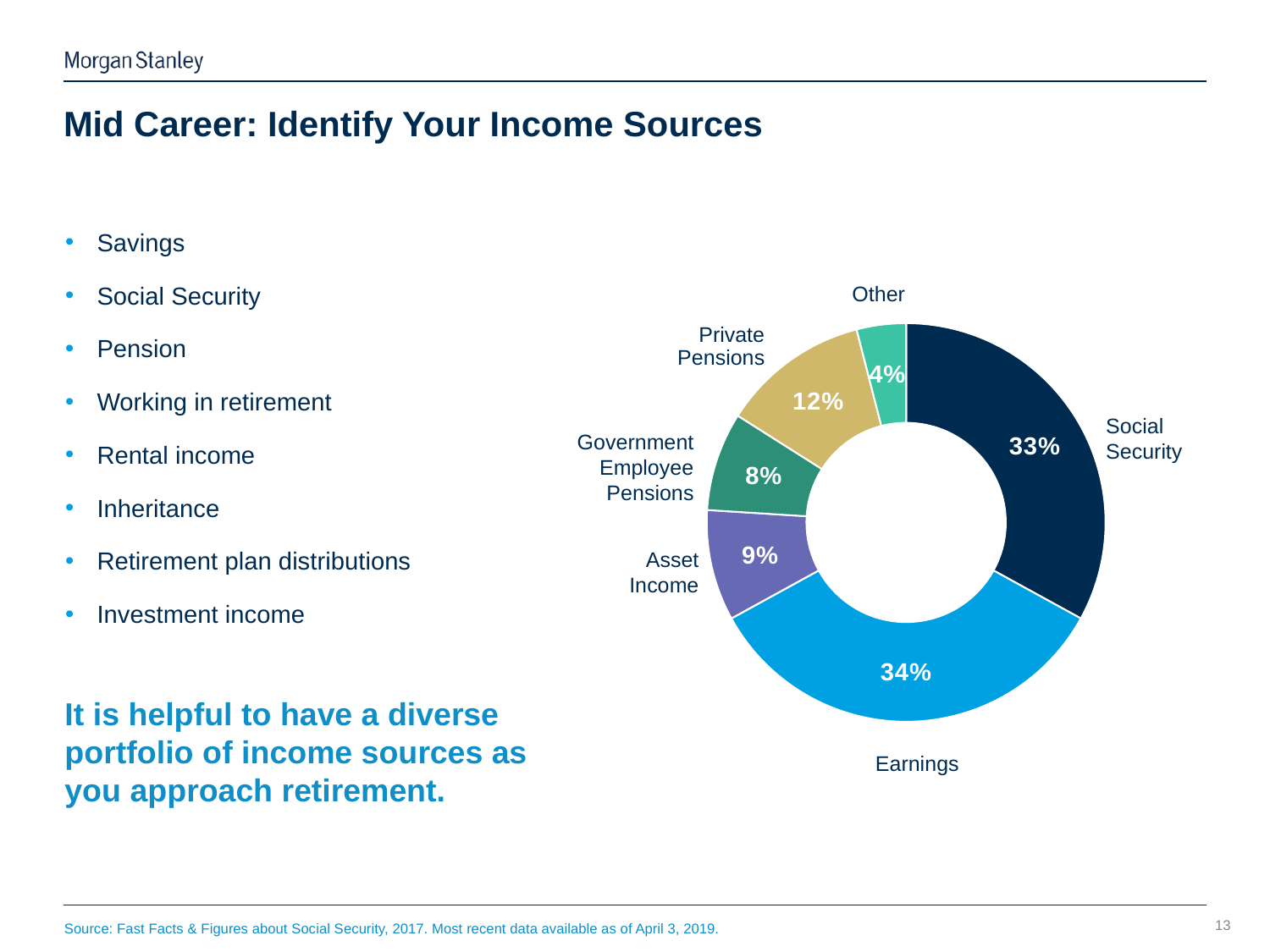
What percentage does the Earnings slice represent? 34% What is the combined share of Private Pensions and Government Employee Pensions? 20% Which category has the smallest share of the chart? Other What percentage is shown for Government Employee Pensions? 8% Which category has the largest share of the chart? Earnings How many categories are shown in the chart? 6 What is the value for Asset Income? 9% What kind of chart is shown on the slide? Pie chart (donut) What share of the chart is Social Security? 33% Which is larger, Private Pensions or Asset Income? Private Pensions What is the value shown for Private Pensions? 12% What is the difference in percentage points between Earnings and Social Security? 1